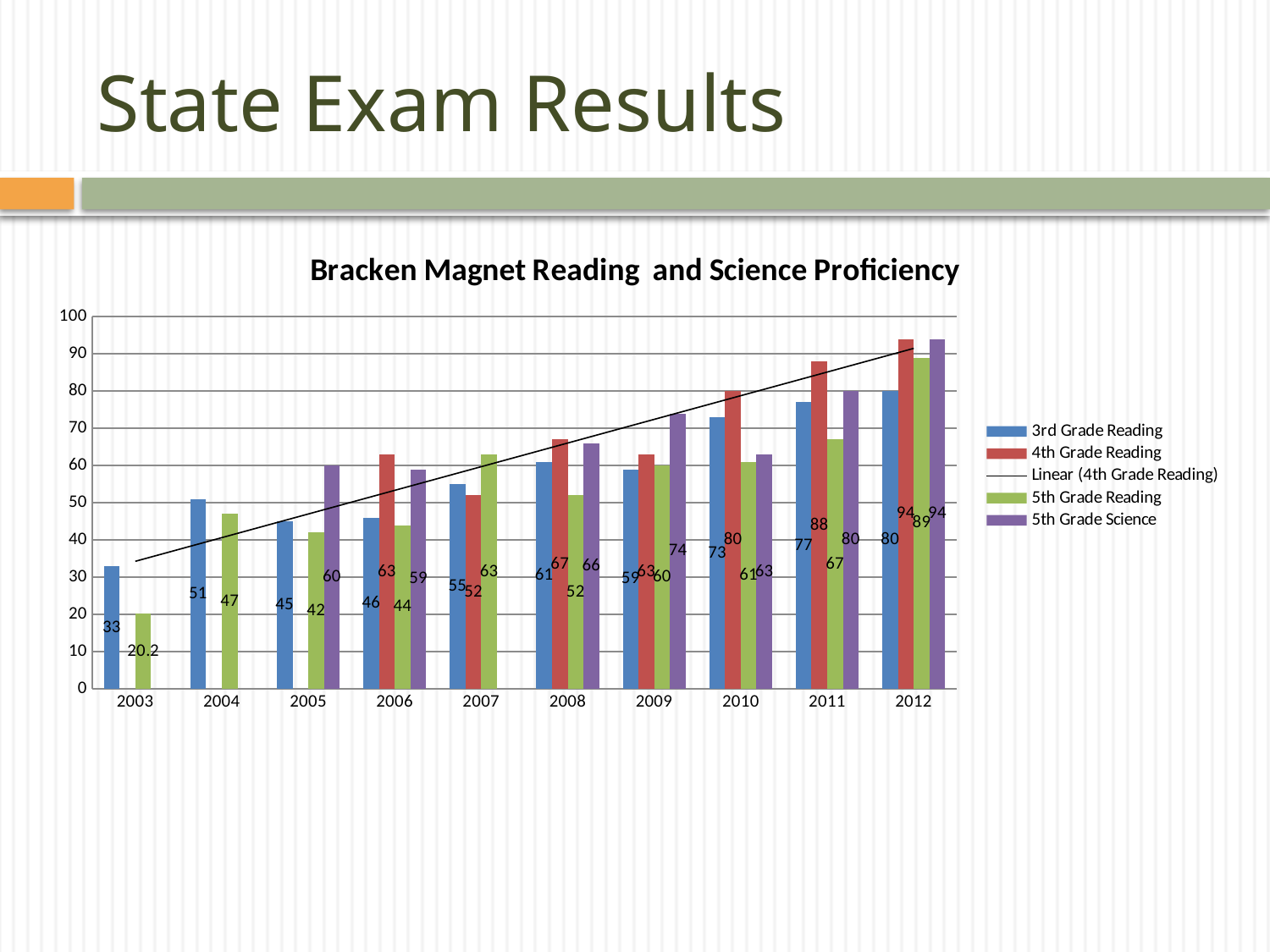
In which year is 3rd Grade Reading highest? 2012 How many years are shown on the x axis? 10 Which is larger in 2010: 4th Grade Reading or 5th Grade Science? 4th Grade Reading What kind of chart is this? Bar chart What is the 4th Grade Reading value for 2011? 88 What is the 3rd Grade Reading value for 2003? 33 How many entries does the legend list? 5 What is the difference between 4th Grade Reading and 3rd Grade Reading in 2012? 14 What is the 5th Grade Reading value for 2003? 20.2 What is the title of the chart? Bracken Magnet Reading and Science Proficiency What is the 5th Grade Science value for 2009? 74 In which year is 5th Grade Reading lowest? 2003